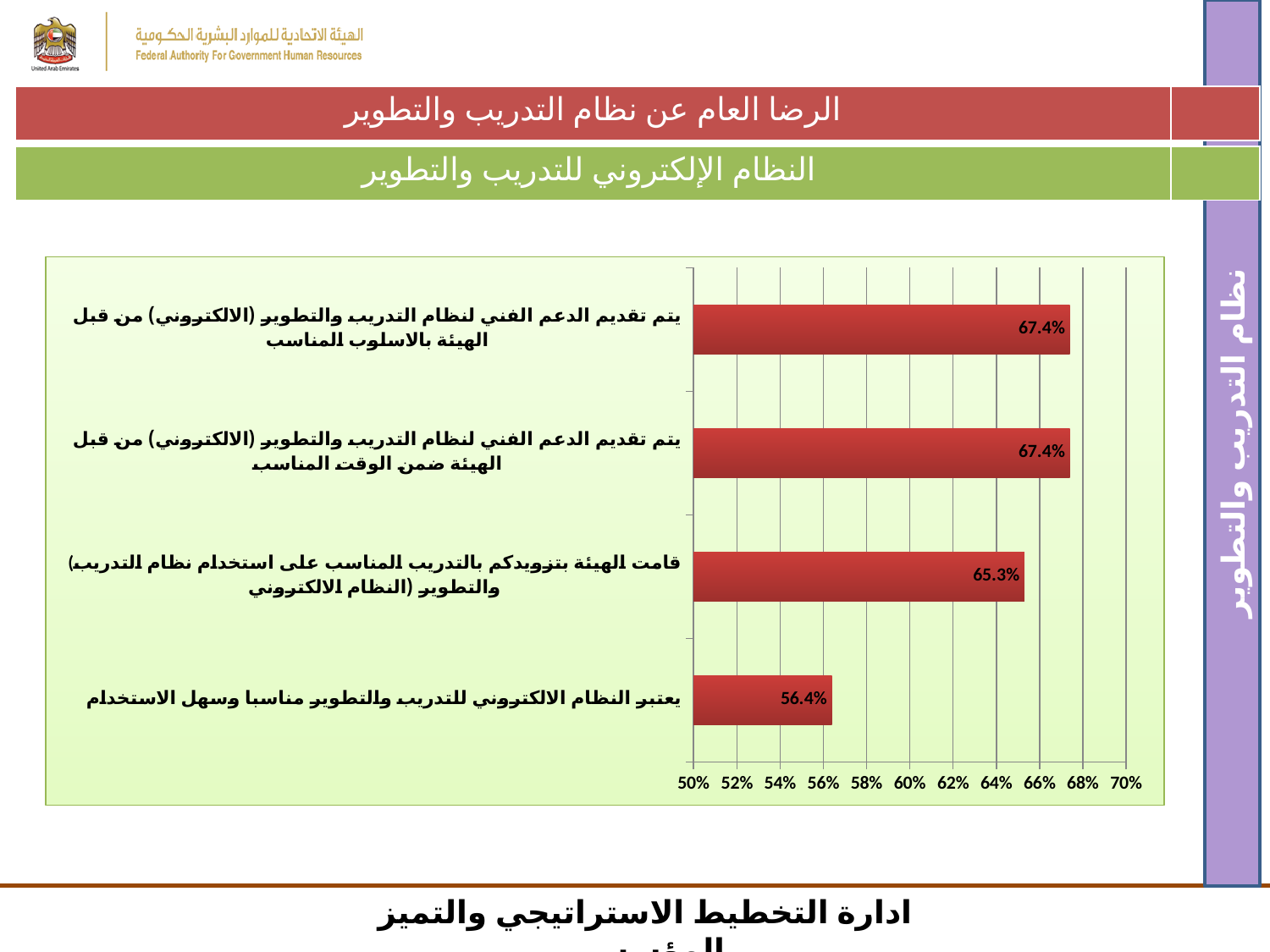
Which category has the lowest value? يعتبر النظام الالكتروني للتدريب والتطوير مناسبا وسهل الاستخدام What is the difference between the value for "يتم تقديم الدعم الفني لنظام التدريب والتطوير (الالكتروني) من قبل الهيئة ضمن الوقت المناسب" and the value for "قامت الهيئة بتزويدكم بالتدريب المناسب على استخدام نظام التدريب والتطوير (النظام الالكتروني)"? 2.1% How many categories (bars) does the chart show? 4 What is the value for "يعتبر النظام الالكتروني للتدريب والتطوير مناسبا وسهل الاستخدام"? 56.4% Is the value for "يعتبر النظام الالكتروني للتدريب والتطوير مناسبا وسهل الاستخدام" greater or less than 60%? less What kind of chart is shown on the slide? bar chart What is the value for "قامت الهيئة بتزويدكم بالتدريب المناسب على استخدام نظام التدريب والتطوير (النظام الالكتروني)"? 65.3% What is the title shown in the green bar above the chart? النظام الإلكتروني للتدريب والتطوير What is the value for "يتم تقديم الدعم الفني لنظام التدريب والتطوير (الالكتروني) من قبل الهيئة بالاسلوب المناسب"? 67.4% Which is larger: the value for "قامت الهيئة بتزويدكم بالتدريب المناسب على استخدام نظام التدريب والتطوير (النظام الالكتروني)" or the value for "يعتبر النظام الالكتروني للتدريب والتطوير مناسبا وسهل الاستخدام"? قامت الهيئة بتزويدكم بالتدريب المناسب على استخدام نظام التدريب والتطوير (النظام الالكتروني) What is the difference between the value for "قامت الهيئة بتزويدكم بالتدريب المناسب على استخدام نظام التدريب والتطوير (النظام الالكتروني)" and the value for "يعتبر النظام الالكتروني للتدريب والتطوير مناسبا وسهل الاستخدام"? 8.9% What is the value for "يتم تقديم الدعم الفني لنظام التدريب والتطوير (الالكتروني) من قبل الهيئة ضمن الوقت المناسب"? 67.4%